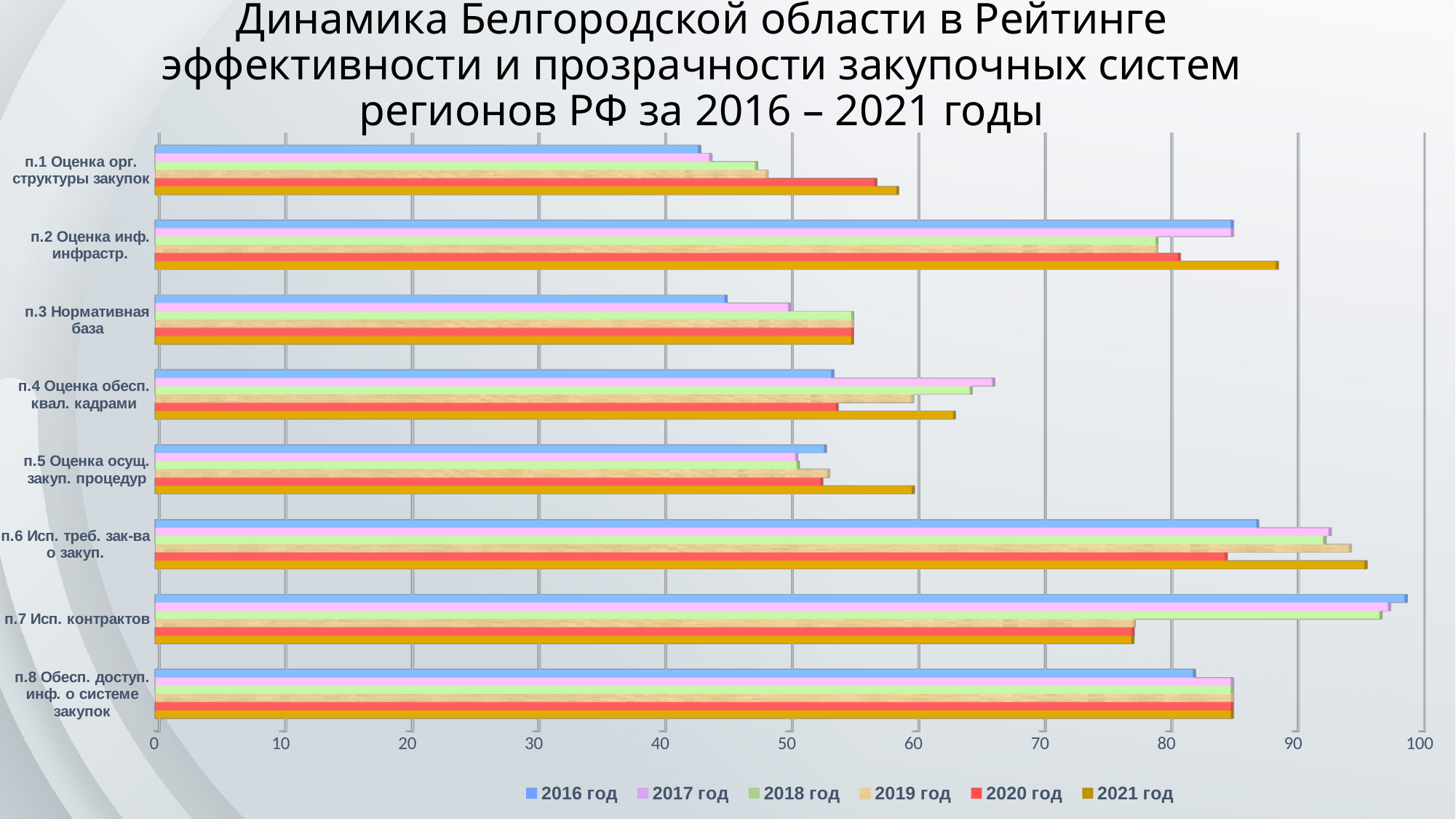
Is the value for п.2 Оценка инф. инфрастр. in 2021 год greater or less than 80? greater How many series does the legend list? 6 How many categories (п.1 to п.8) are plotted on the chart? 8 Is the value for п.1 Оценка орг. структуры закупок in 2016 год greater or less than 50? less Which category has the highest value for 2021 год? п.6 Исп. треб. зак-ва о закуп. Is the value for п.7 Исп. контрактов in 2020 год greater or less than 80? less For п.1 Оценка орг. структуры закупок, which is larger: the 2016 год value or the 2021 год value? 2021 год Which series is listed first in the legend? 2016 год What kind of chart is shown on the slide? bar chart For п.7 Исп. контрактов, which is larger: the 2016 год value or the 2021 год value? 2016 год